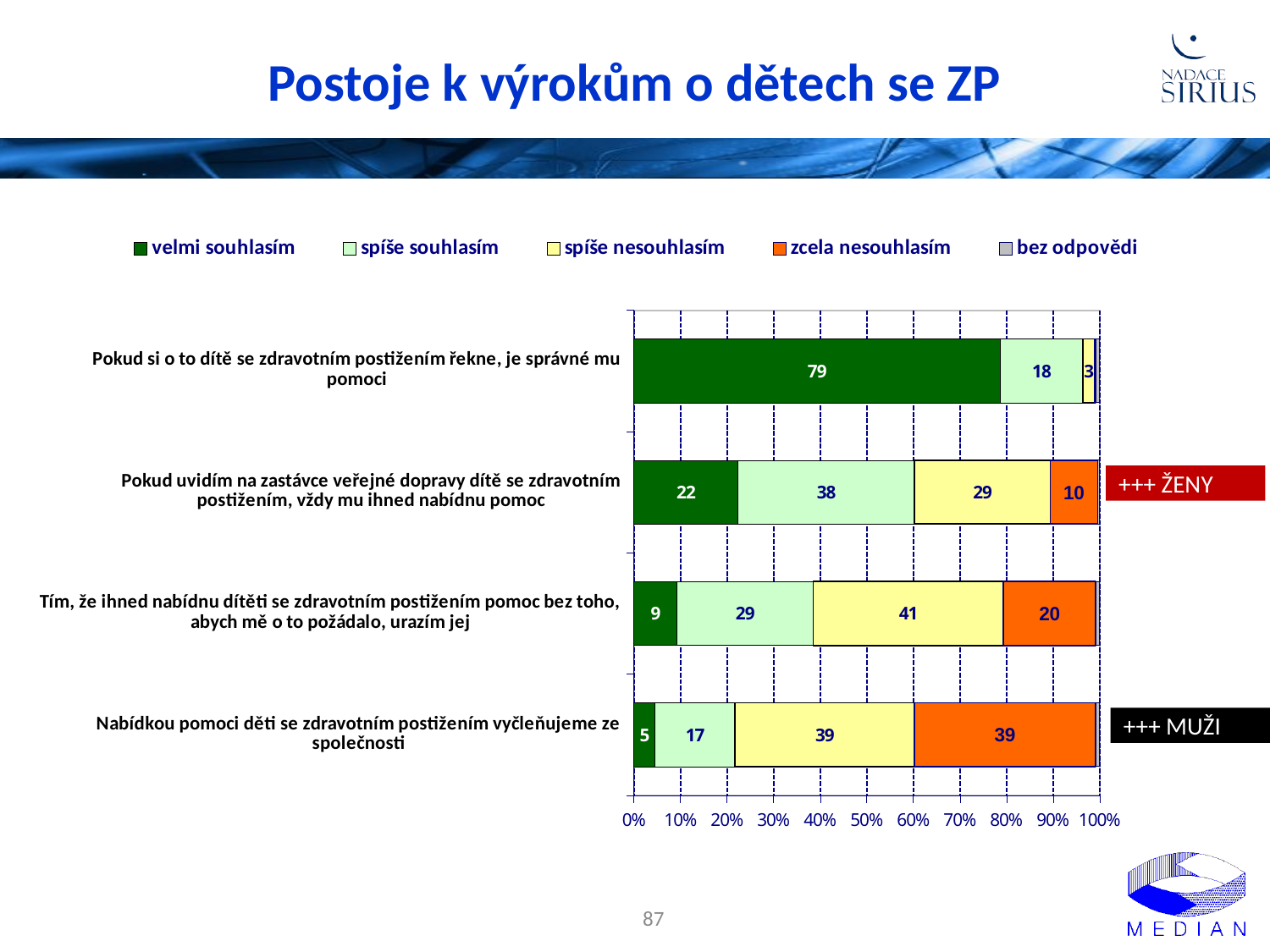
What is the 'spíše souhlasím' value for the statement 'Pokud uvidím na zastávce veřejné dopravy dítě se zdravotním postižením, vždy mu ihned nabídnu pomoc'? 38 What is the difference between the 'zcela nesouhlasím' values for 'Nabídkou pomoci děti se zdravotním postižením vyčleňujeme ze společnosti' and 'Pokud uvidím na zastávce veřejné dopravy dítě se zdravotním postižením, vždy mu ihned nabídnu pomoc'? 29 Which statement has the lowest 'velmi souhlasím' value? Nabídkou pomoci děti se zdravotním postižením vyčleňujeme ze společnosti What kind of chart is shown on the slide? stacked bar chart Which statement has the highest 'velmi souhlasím' value? Pokud si o to dítě se zdravotním postižením řekne, je správné mu pomoci Which is larger: the 'spíše souhlasím' value for 'Pokud uvidím na zastávce veřejné dopravy dítě se zdravotním postižením, vždy mu ihned nabídnu pomoc' or for 'Tím, že ihned nabídnu dítěti se zdravotním postižením pomoc bez toho, abych mě o to požádalo, urazím jej'? Pokud uvidím na zastávce veřejné dopravy dítě se zdravotním postižením, vždy mu ihned nabídnu pomoc What is the 'velmi souhlasím' value for the statement 'Pokud si o to dítě se zdravotním postižením řekne, je správné mu pomoci'? 79 What is the 'spíše nesouhlasím' value for the statement 'Tím, že ihned nabídnu dítěti se zdravotním postižením pomoc bez toho, abych mě o to požádalo, urazím jej'? 41 What is the 'zcela nesouhlasím' value for the statement 'Nabídkou pomoci děti se zdravotním postižením vyčleňujeme ze společnosti'? 39 How many series does the legend list? 5 What colour represents the 'zcela nesouhlasím' series in the legend? orange How many statements (categories) are plotted in the chart? 4